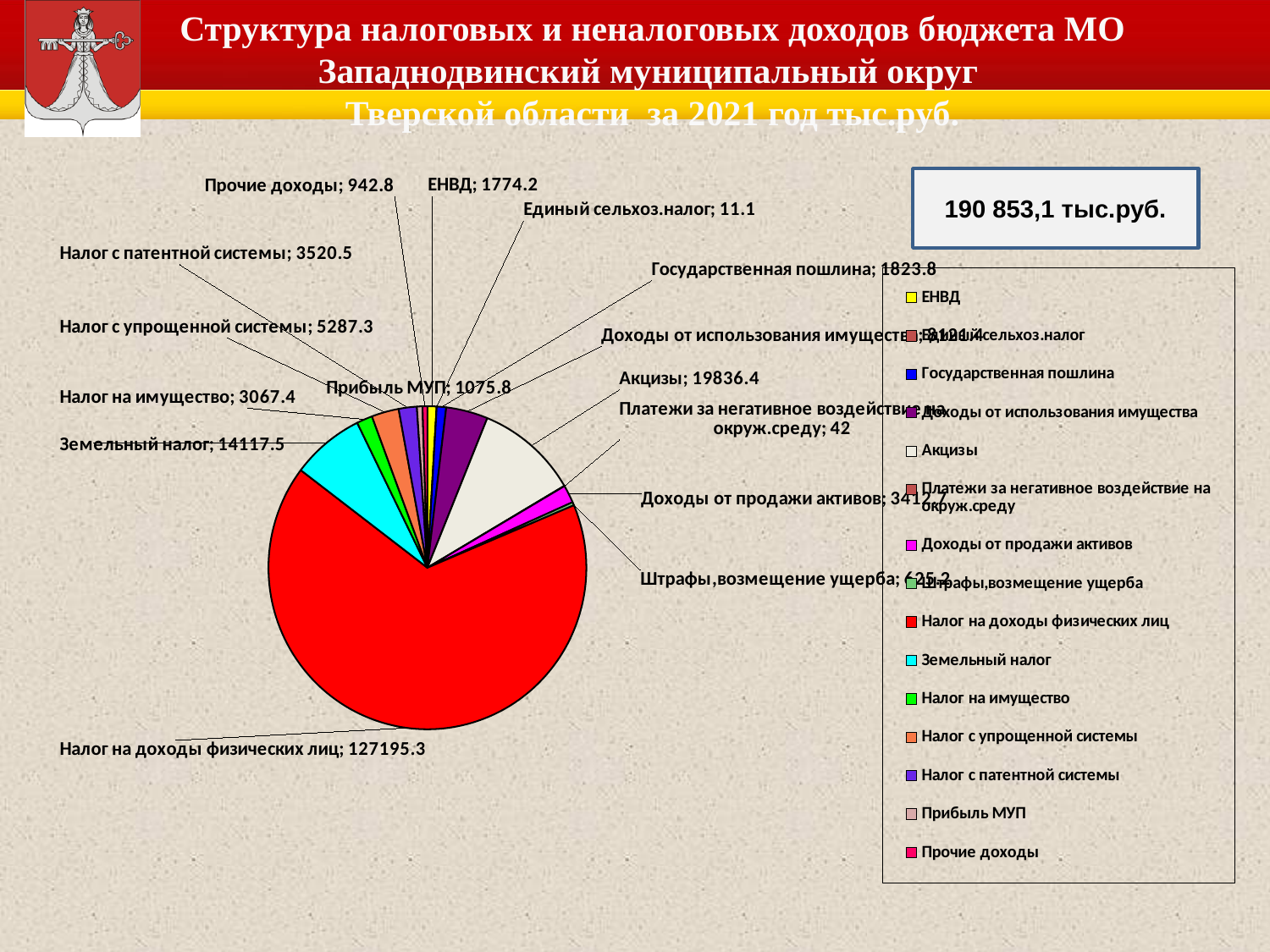
Which is larger, Налог с упрощенной системы or Налог с патентной системы? Налог с упрощенной системы Which category has the largest slice of the pie chart? Налог на доходы физических лиц What is the value for Платежи за негативное воздействие на окруж.среду in the pie chart? 42 What is the value for Земельный налог in the pie chart? 14117.5 What is the difference between Земельный налог and Налог на имущество? 11050.1 Which category has the smallest value in the pie chart? Единый сельхоз.налог What is the value for ЕНВД in the pie chart? 1774.2 What is the value for Налог на доходы физических лиц in the pie chart? 127195.3 What is the value for Акцизы in the pie chart? 19836.4 What kind of chart is shown on the slide? Pie chart What total amount is shown in the box at the top right of the slide? 190 853,1 тыс.руб. How many categories does the legend of the pie chart list? 15